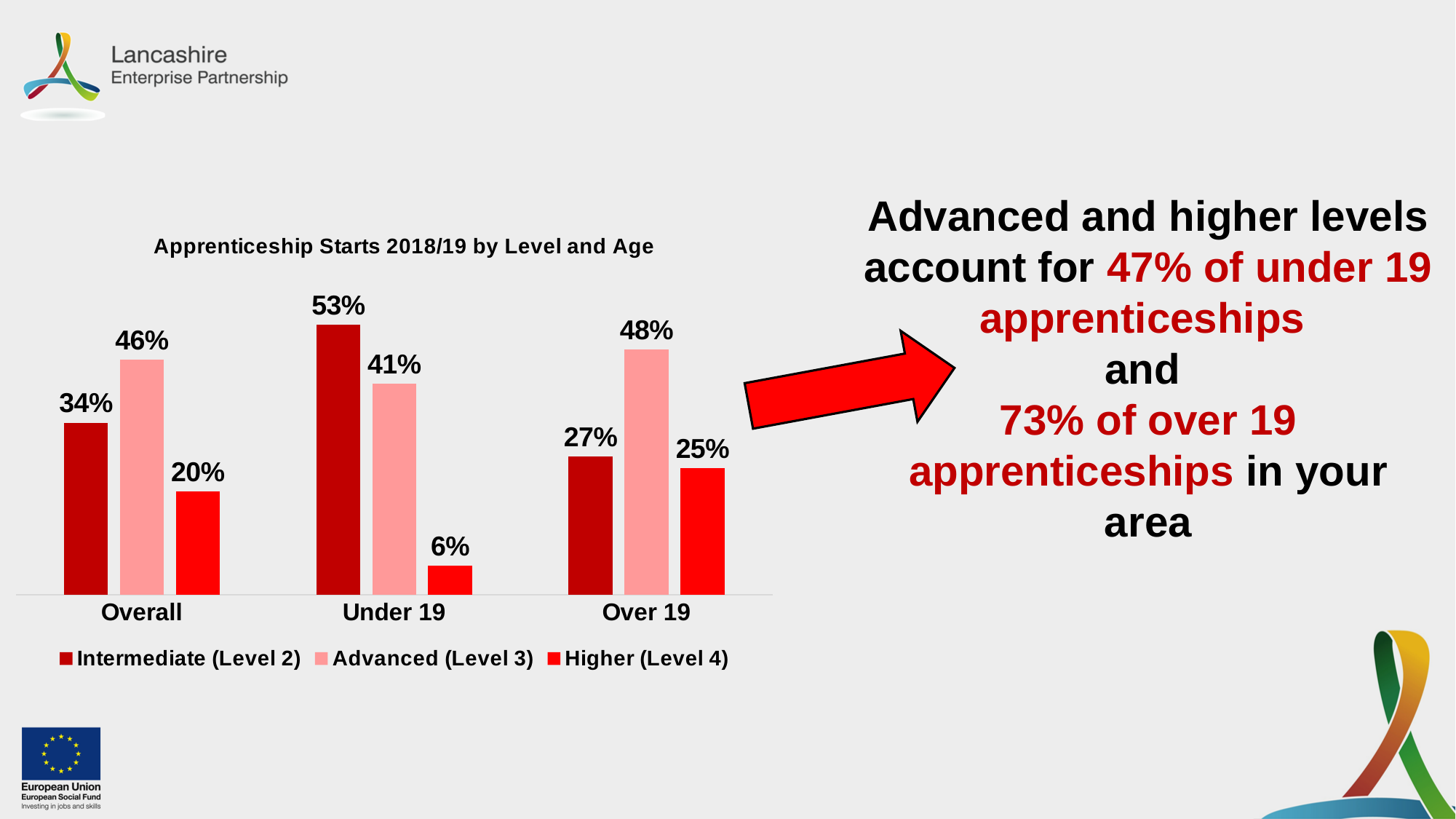
What is the value for Intermediate (Level 2) in the Overall category? 34% Which category has the highest value for Intermediate (Level 2)? Under 19 What is the title of the chart? Apprenticeship Starts 2018/19 by Level and Age Which is larger in the Under 19 category: Intermediate (Level 2) or Advanced (Level 3)? Intermediate (Level 2) What is the value for Higher (Level 4) in the Under 19 category? 6% What is the value for Advanced (Level 3) in the Over 19 category? 48% What is the difference between the Higher (Level 4) values for Over 19 and Under 19? 19% What is the difference between the Advanced (Level 3) and Intermediate (Level 2) values in the Over 19 category? 21% What kind of chart is shown on the slide? Bar chart How many series does the legend list? 3 How many categories are shown on the x axis? 3 Which category has the lowest value for Higher (Level 4)? Under 19